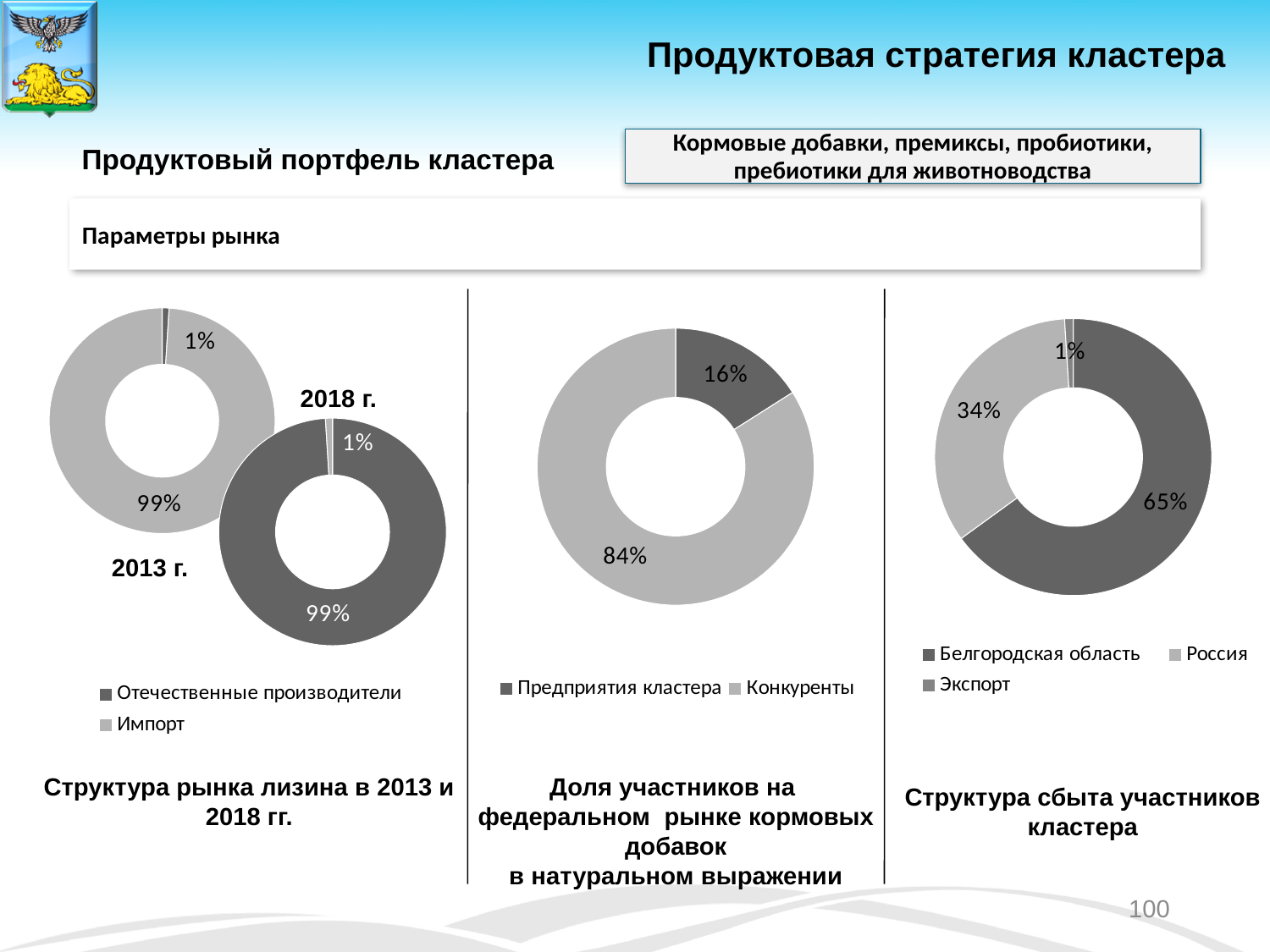
In the chart 'Доля участников на федеральном рынке кормовых добавок в натуральном выражении', what share do Конкуренты hold? 84% In the chart 'Структура рынка лизина в 2013 и 2018 гг.', what share did Импорт have in 2013? 99% In the chart 'Структура сбыта участников кластера', what is the share for Белгородская область? 65% In the chart 'Структура сбыта участников кластера', what is the share for Экспорт? 1% In the chart 'Доля участников на федеральном рынке кормовых добавок в натуральном выражении', what share do Предприятия кластера hold? 16% In the chart 'Структура рынка лизина в 2013 и 2018 гг.', what share did Отечественные производители have in 2018? 99% How many entries does the legend of the chart 'Структура сбыта участников кластера' list? 3 In the chart 'Структура сбыта участников кластера', which category has the largest share? Белгородская область What kind of chart is 'Доля участников на федеральном рынке кормовых добавок в натуральном выражении'? Doughnut (pie) chart In the chart 'Структура сбыта участников кластера', what is the difference between the shares of Белгородская область and Россия? 31% In the chart 'Структура сбыта участников кластера', which category has the smallest share? Экспорт In the chart 'Структура сбыта участников кластера', what is the share for Россия? 34%